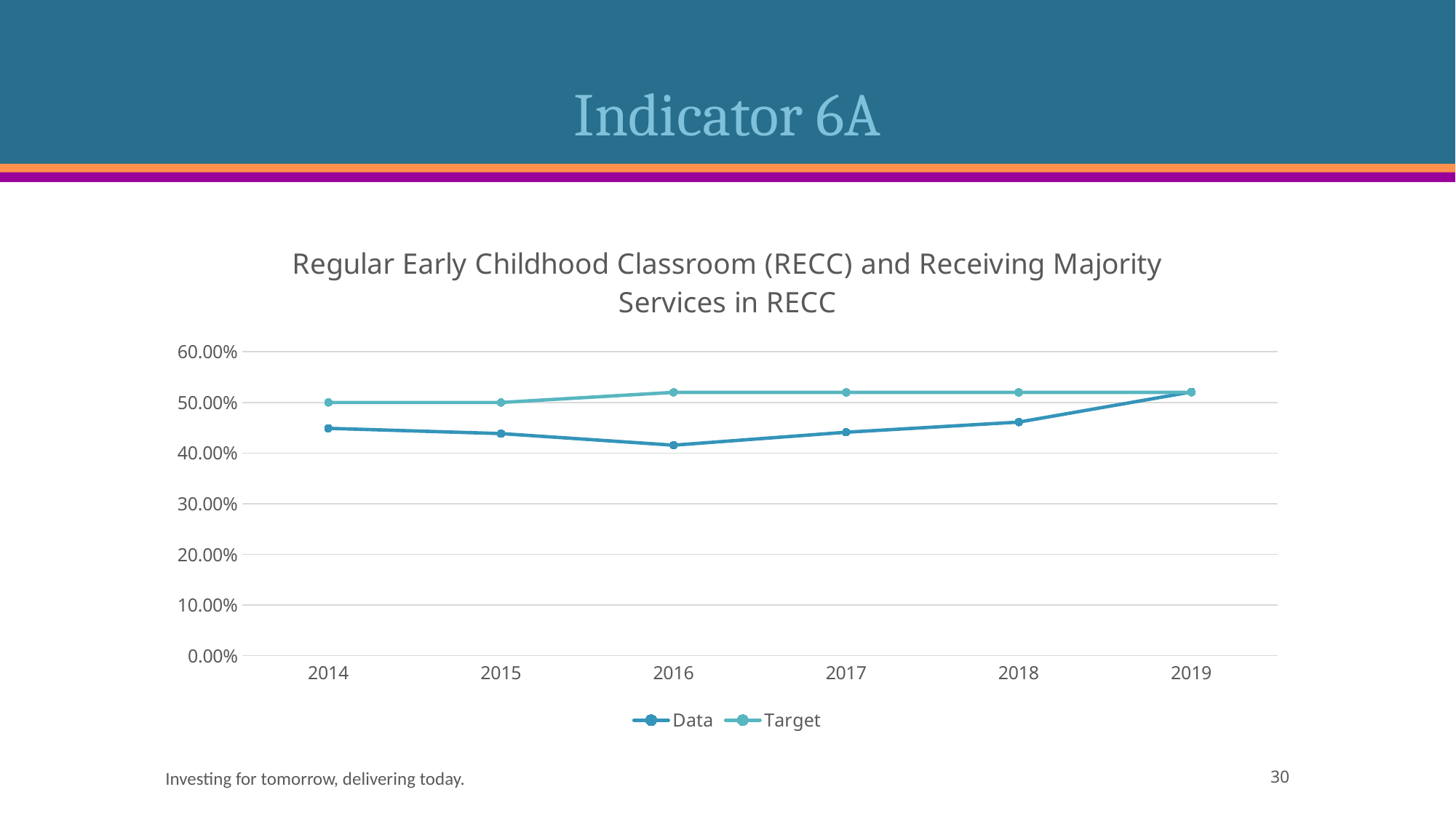
How many series does the legend list? 2 What kind of chart is shown on the slide? Line chart Does the Data series rise or fall from 2014 to 2016? Fall What is the Target value for 2014? 50.00% In which year is the Data series at its lowest? 2016 Is the Data value for 2016 greater or less than 50.00%? less In which year is the Data series at its highest? 2019 Is the Target value for 2017 greater or less than 50.00%? greater What are the two series named in the legend? Data and Target What is the title of the chart? Regular Early Childhood Classroom (RECC) and Receiving Majority Services in RECC In 2016, which series has the higher value, Data or Target? Target How many years are plotted along the x axis? 6